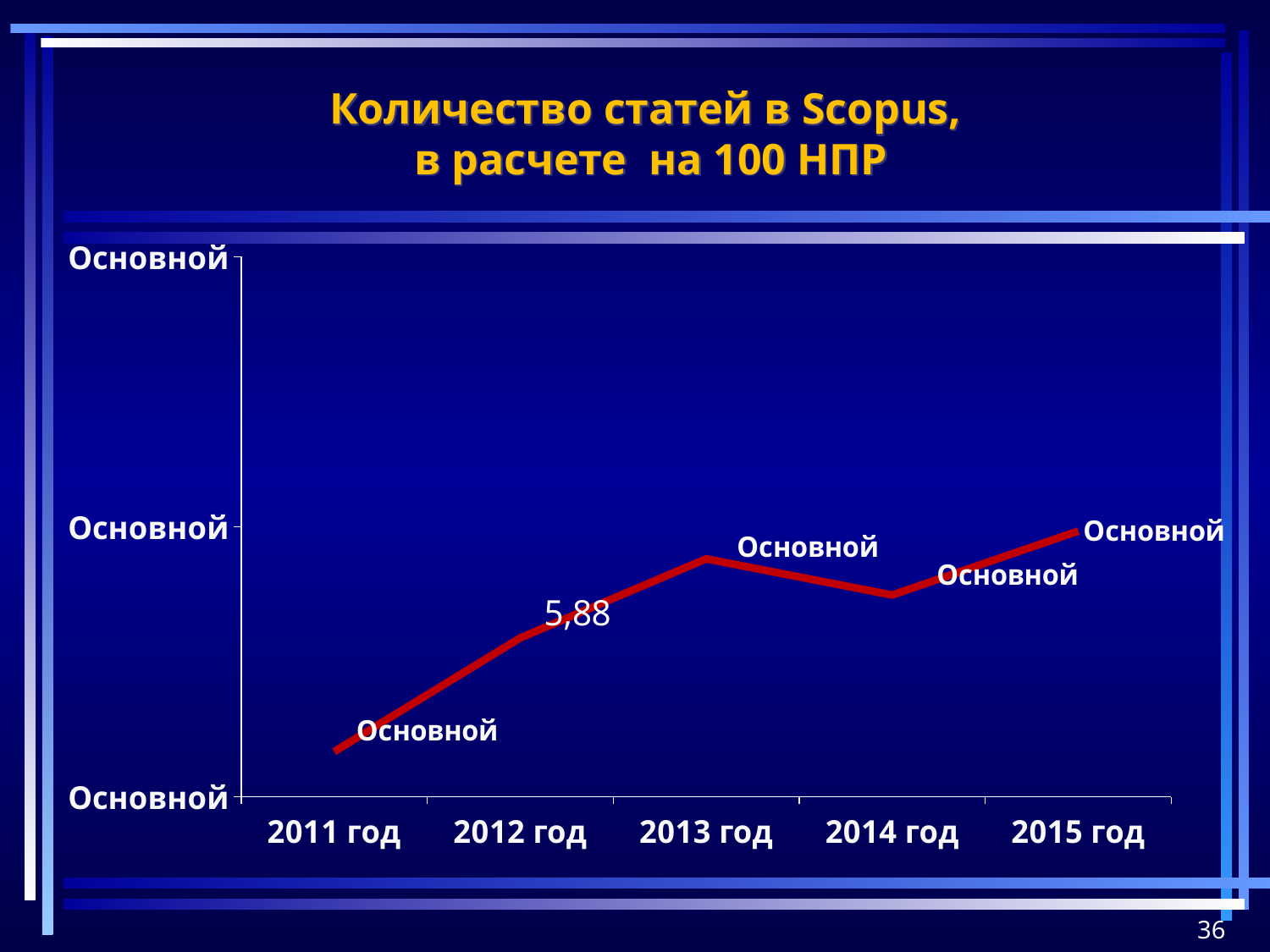
Which is larger, the value for 2013 год or for 2014 год? 2013 год How many years are plotted on the x axis? 5 What colour is the plotted line? red Does the value rise or fall from 2013 год to 2014 год? fall Which is larger, the value for 2011 год or for 2012 год? 2012 год What is the value for 2012 год? 5,88 What is the title of the chart? Количество статей в Scopus, в расчете на 100 НПР Which year has the highest value? 2015 год Which year has the lowest value? 2011 год What type of chart is shown on the slide? line chart Does the value rise or fall from 2011 год to 2013 год? rise